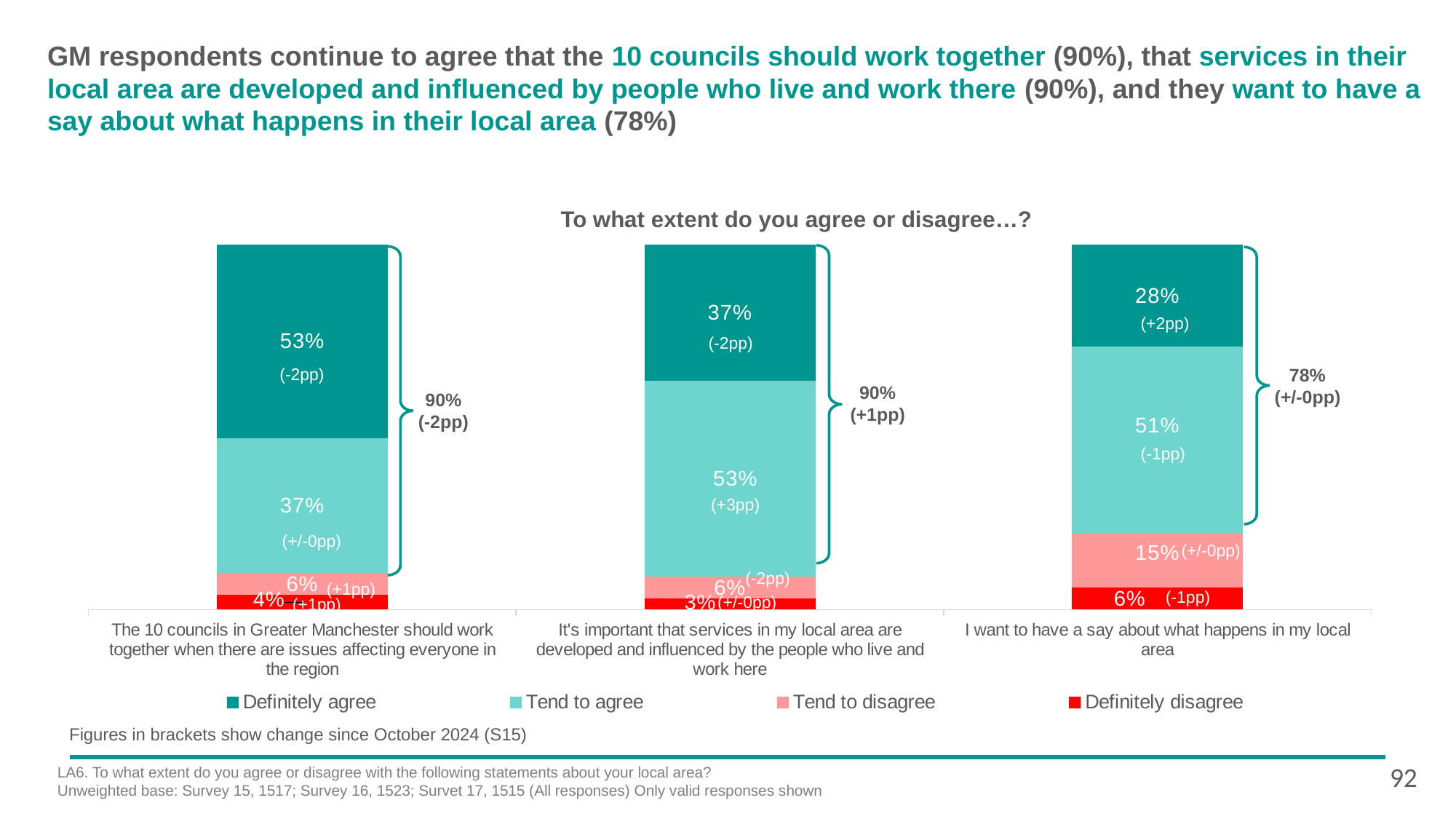
How many statements are shown on the chart? 3 Which statement has the lowest 'Definitely disagree' percentage? It's important that services in my local area are developed and influenced by the people who live and work here Is the 'Tend to agree' percentage larger for the services statement or for the having a say statement? The services statement (53%) What is the combined agree figure shown by the bracket for 'I want to have a say about what happens in my local area'? 78% What percentage of respondents definitely agree that the 10 councils in Greater Manchester should work together when there are issues affecting everyone in the region? 53% Which statement has the highest 'Definitely agree' percentage? The 10 councils in Greater Manchester should work together when there are issues affecting everyone in the region What is the total of the 'Definitely agree' and 'Tend to agree' segments for the statement about the 10 councils working together? 90% How many series does the legend list? 4 What percentage of respondents tend to disagree with the statement 'I want to have a say about what happens in my local area'? 15% What kind of chart is shown on the slide? Stacked bar chart What percentage of respondents tend to agree that it's important that services in their local area are developed and influenced by the people who live and work there? 53% What is the difference in percentage points between the 'Definitely agree' values for the 10 councils working together statement (53%) and the having a say statement (28%)? 25 percentage points